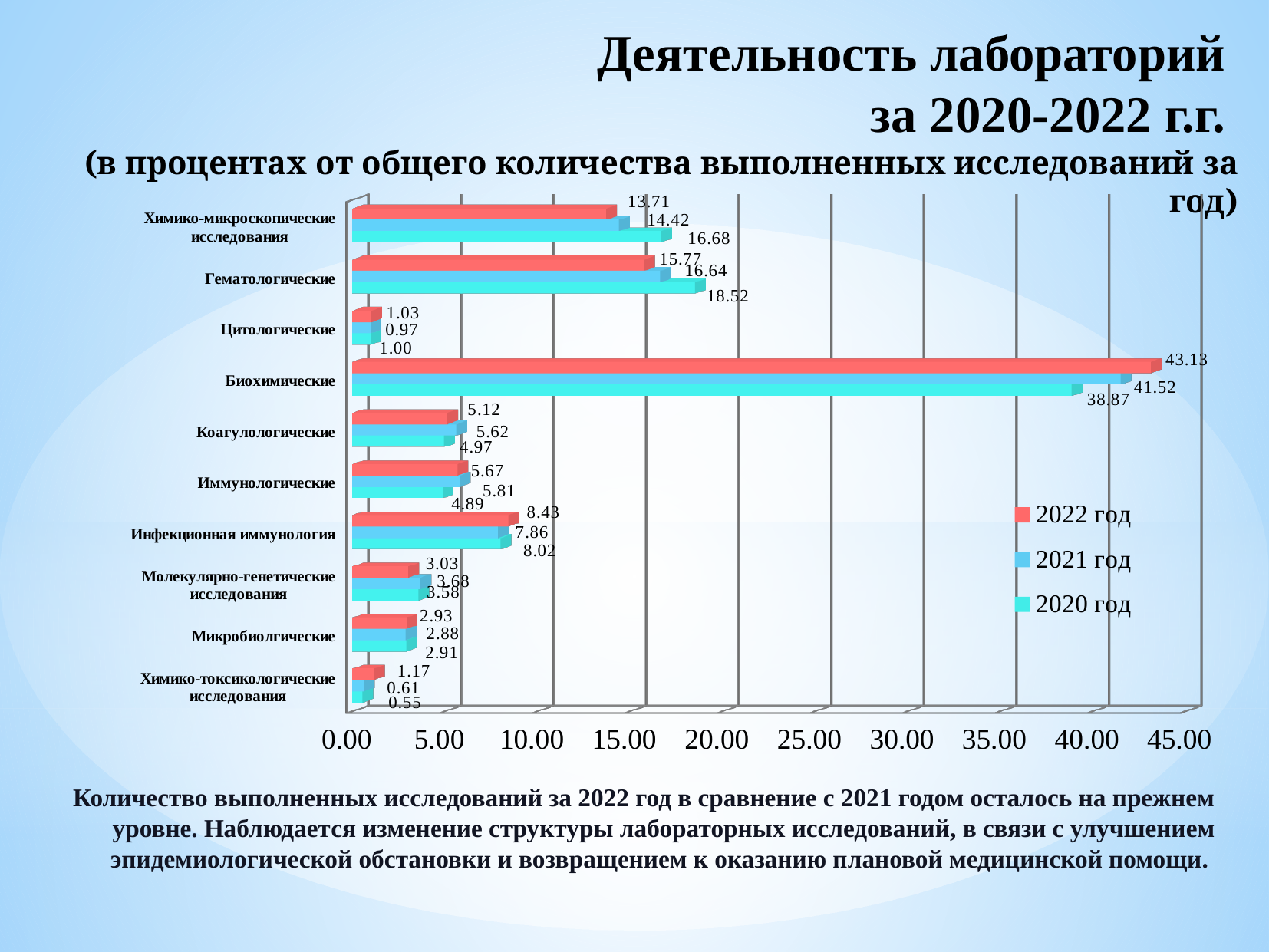
Is the 2021 год value for Биохимические greater or less than 40.00? greater How many series does the legend list? 3 What is the value for Гематологические in the 2020 год series? 18.52 How many categories are shown on the chart? 10 What kind of chart is shown on the slide? Bar chart What is the value for Инфекционная иммунология in the 2021 год series? 7.86 What is the value for Биохимические in the 2022 год series? 43.13 Which is larger for Химико-микроскопические исследования: the 2022 год value or the 2020 год value? 2020 год What is the difference between the 2022 год and 2020 год values for Биохимические? 4.26 Which colour represents the 2021 год series in the legend? Blue Which category has the lowest value in the 2020 год series? Химико-токсикологические исследования Which category has the highest value in the 2022 год series? Биохимические